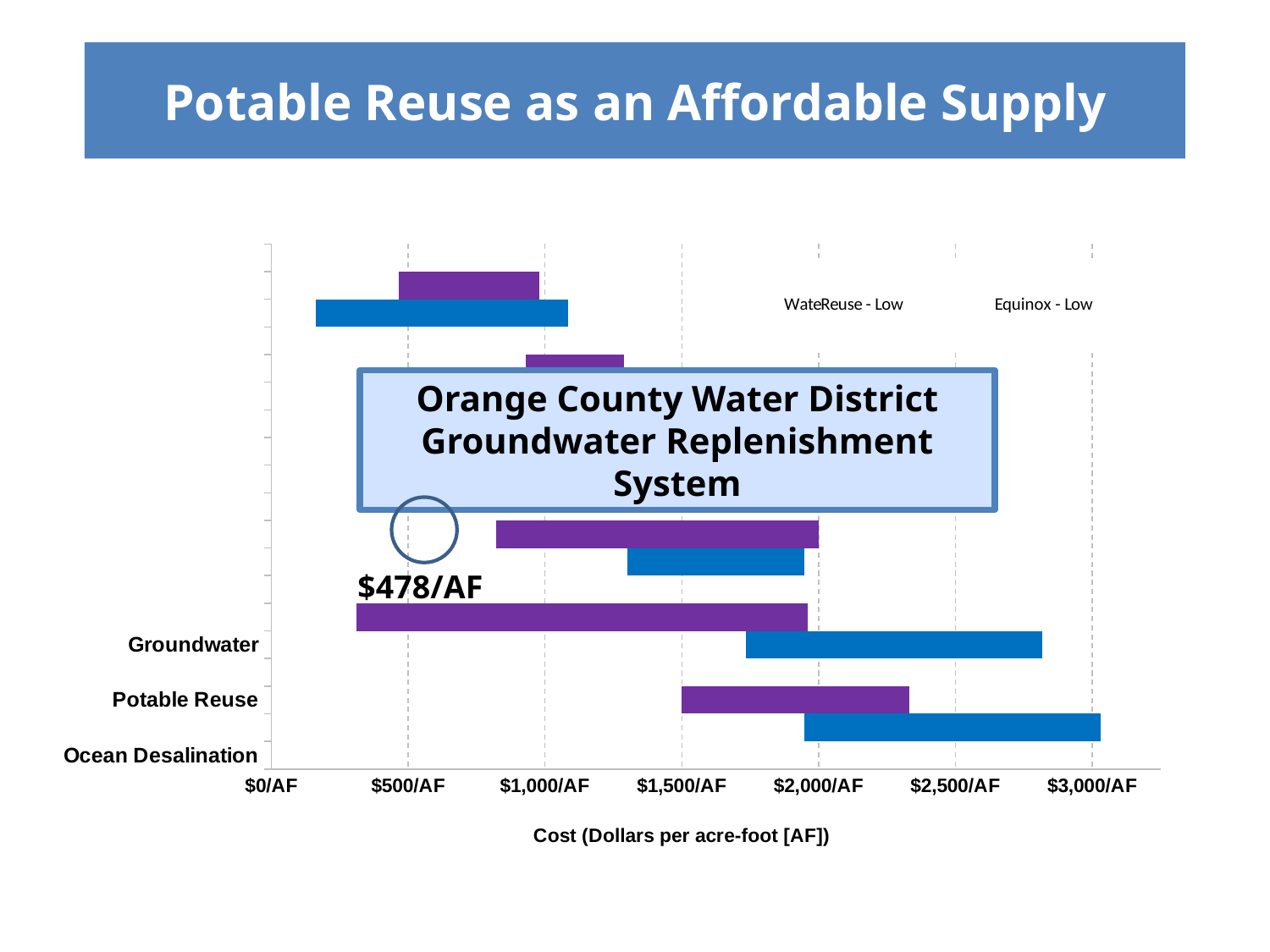
What cost value is annotated with a circle on the chart? $478/AF What is the title of the chart's horizontal axis? Cost (Dollars per acre-foot [AF]) How many category labels are readable on the vertical axis of the chart? 3 How many tick labels are shown on the horizontal axis? 7 What is the lowest tick label on the horizontal axis? $0/AF Is the annotated value of $478/AF greater or less than $500/AF? less What are the two legend entries shown on the chart? WateReuse - Low and Equinox - Low What kind of chart is shown on the slide? bar chart How many series does the chart's legend list? 2 What is the highest tick label on the horizontal axis? $3,000/AF